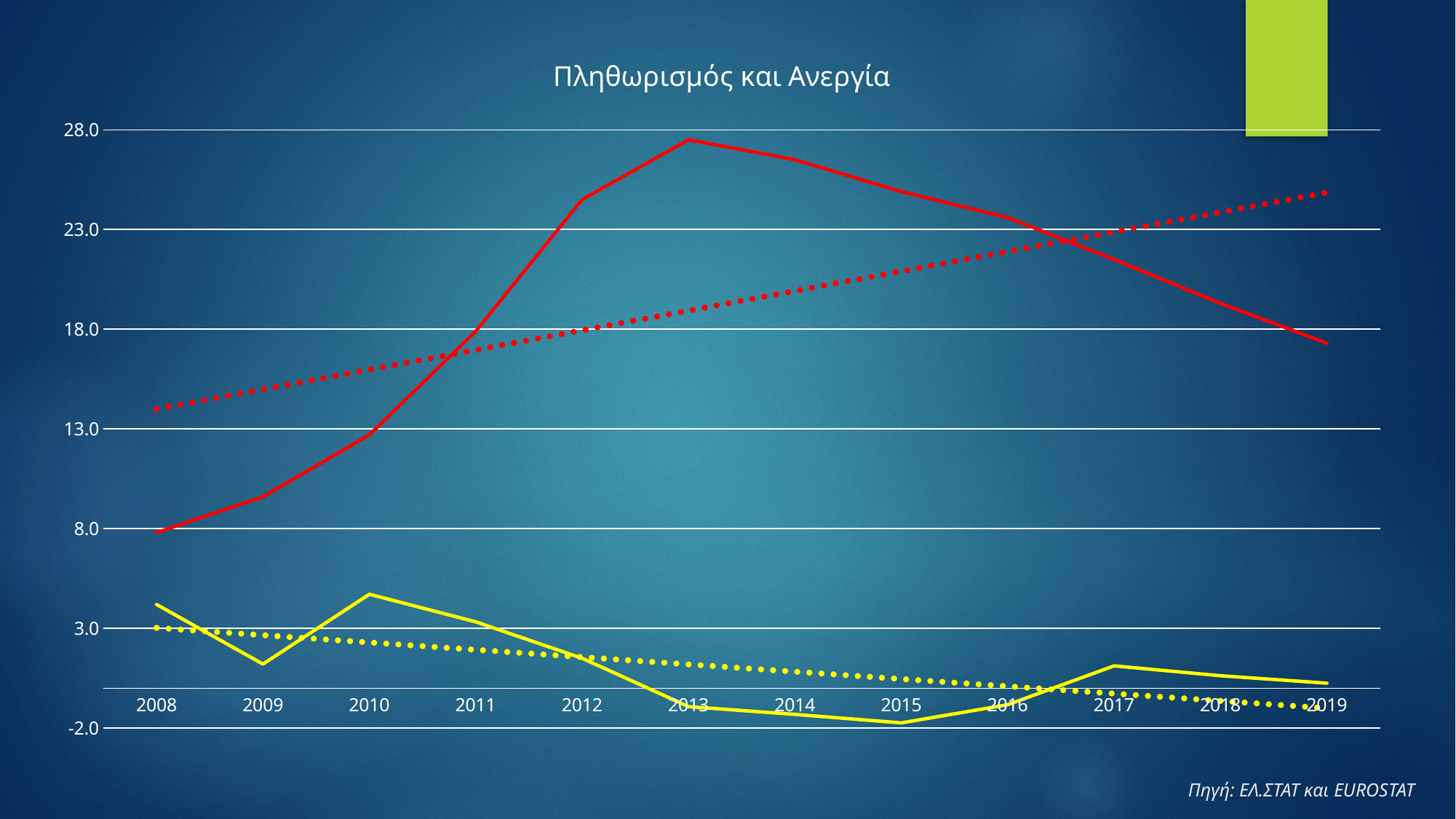
Does the solid red line rise or fall between 2013 and 2019? fall In which year does the solid yellow line have its lowest value? 2015 In which year does the solid yellow line reach its highest value? 2010 Is the value of the solid red line in 2013 greater or less than 23.0? greater How many years are shown along the x axis of the chart? 12 In which year does the solid red line reach its highest value? 2013 Is the value of the solid red line in 2008 greater or less than 13.0? less What is the title of the chart? Πληθωρισμός και Ανεργία Is the value of the solid red line in 2019 greater or less than 23.0? less What kind of chart is shown on the slide? line chart In which year does the solid red line have its lowest value? 2008 Which year has the larger value on the solid red line, 2012 or 2019? 2012